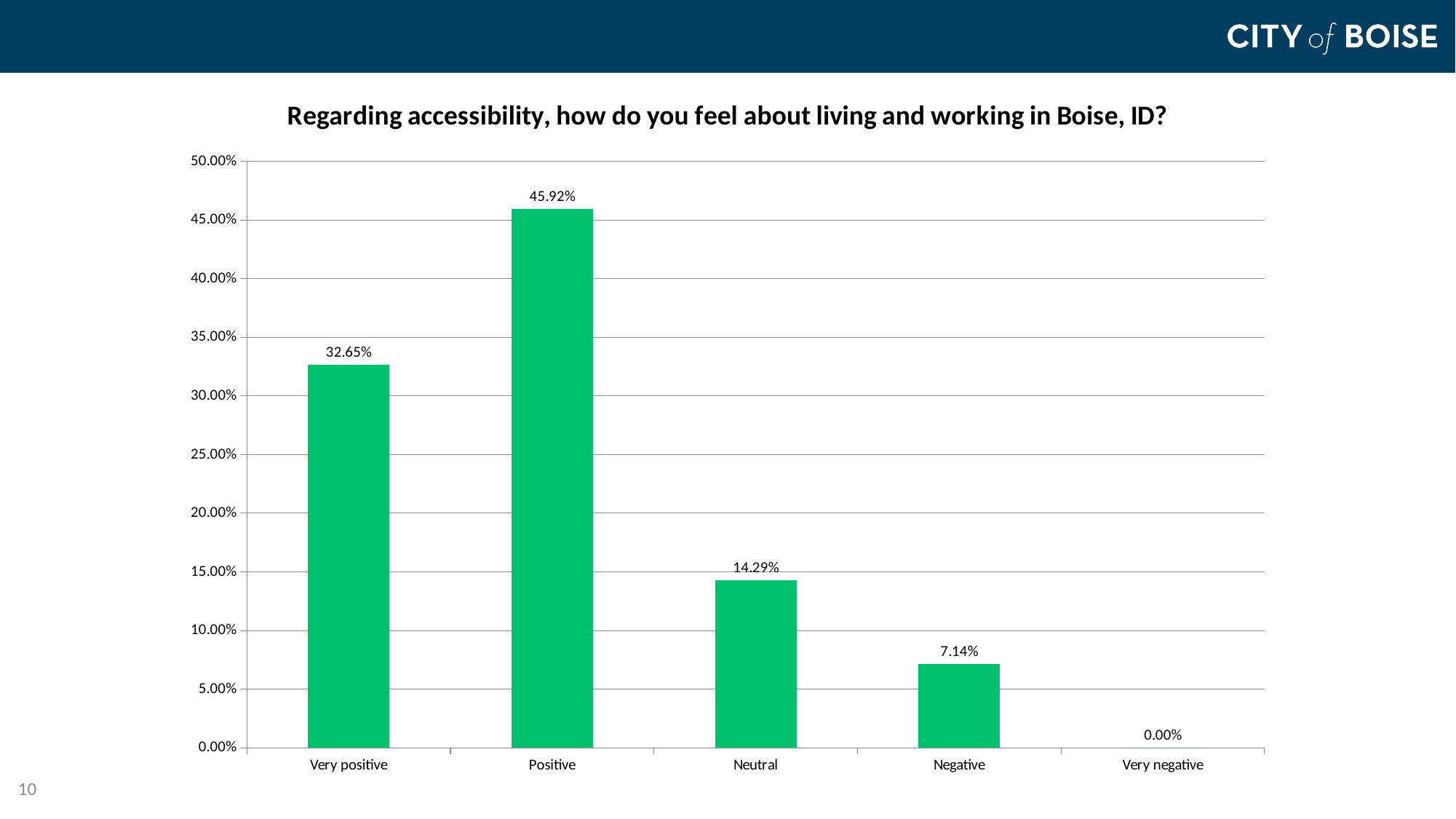
What kind of chart is shown on the slide? Bar chart Which is larger, the value for "Neutral" or the value for "Negative"? Neutral What percentage of respondents answered "Positive"? 45.92% Which response category has the lowest value? Very negative What is the value shown for "Neutral"? 14.29% What is the value shown for "Very negative"? 0.00% What is the title of the chart? Regarding accessibility, how do you feel about living and working in Boise, ID? What percentage of respondents answered "Very positive"? 32.65% Which response category has the highest value? Positive What is the difference between the "Positive" and "Very positive" values? 13.27% Is the value for "Negative" greater or less than 10.00%? less How many response categories are shown on the x axis? 5